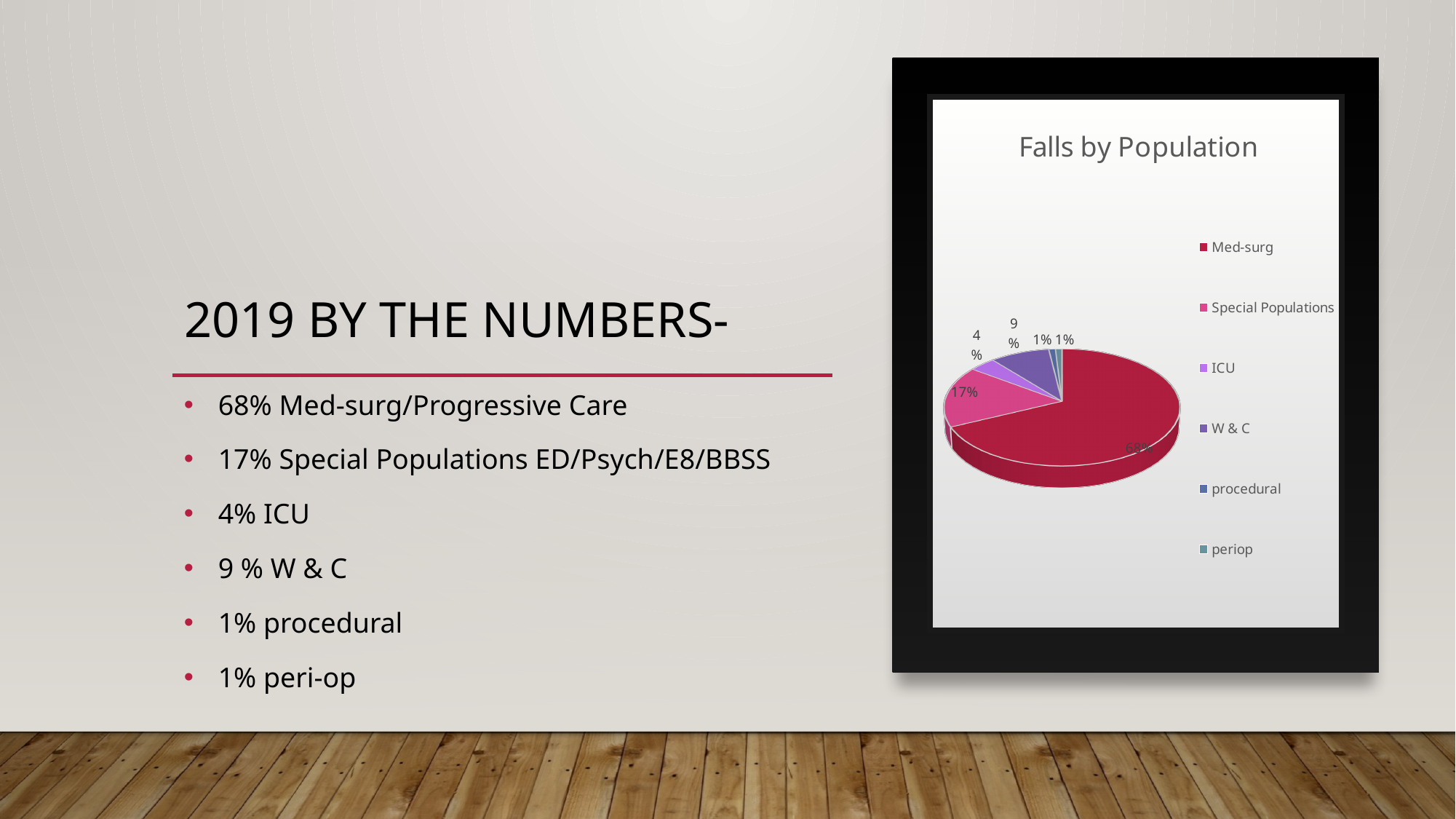
What share of the pie does ICU account for? 4% Which is larger, the slice for W & C or the slice for ICU? W & C What share of the pie does W & C account for? 9% What is the difference between the Med-surg share and the Special Populations share? 51% How many categories does the legend of the pie chart list? 6 What is the combined share of Special Populations and ICU? 21% Which category has the largest slice of the pie? Med-surg Which legend entry is listed last in the pie chart's legend? periop What kind of chart is shown on the slide? pie chart What share of the pie does Med-surg account for? 68% What is the title of the chart? Falls by Population